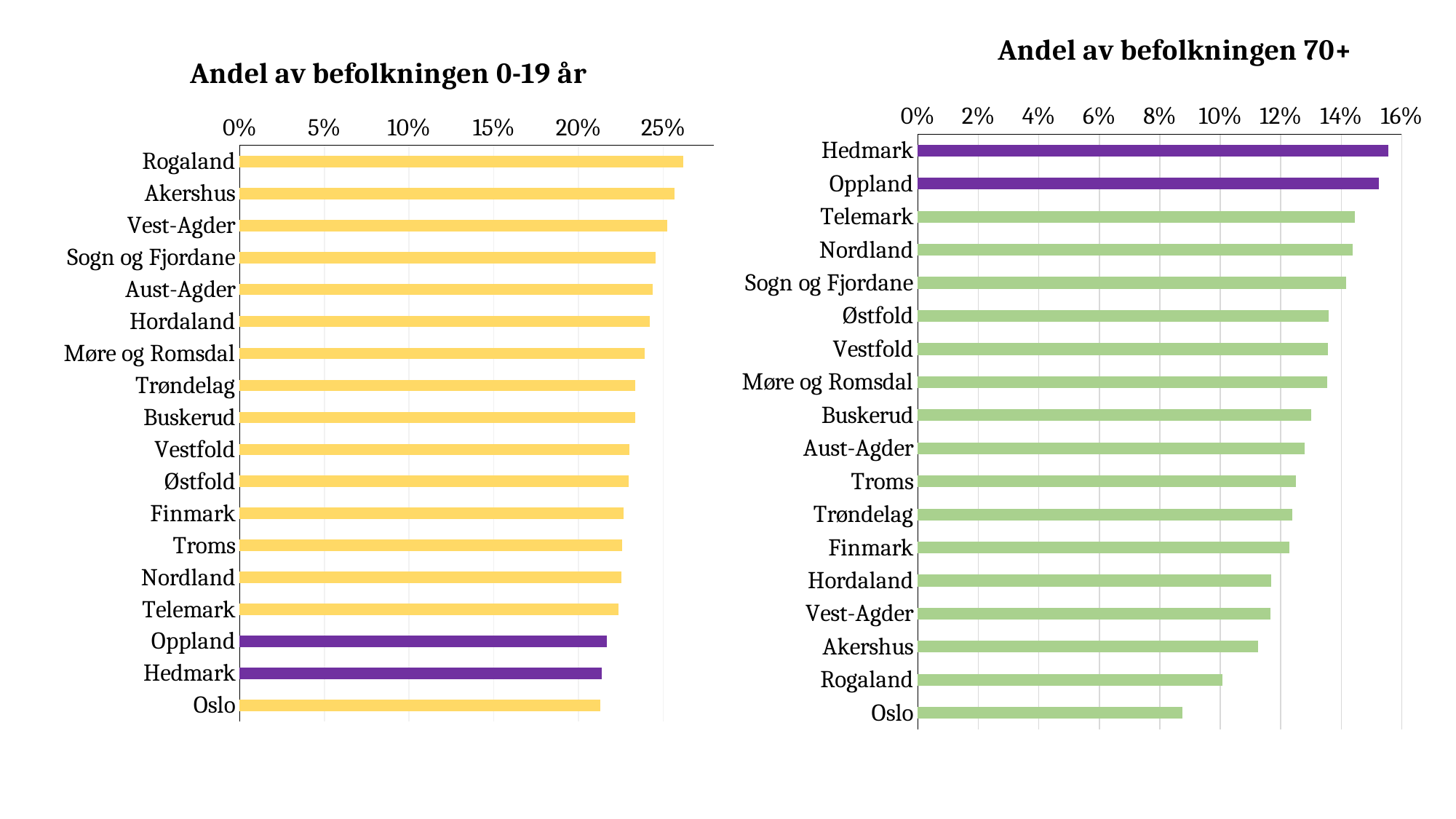
In the 'Andel av befolkningen 0-19 år' chart, which county has the lowest share? Oslo In the 'Andel av befolkningen 70+' chart, which has the larger value, Telemark or Rogaland? Telemark In the 'Andel av befolkningen 70+' chart, is the value for Oslo greater or less than 10%? less In the 'Andel av befolkningen 0-19 år' chart, is the value for Rogaland greater or less than 25%? greater In the 'Andel av befolkningen 70+' chart, which county has the lowest share? Oslo How many counties are shown in the 'Andel av befolkningen 70+' chart? 18 In the 'Andel av befolkningen 70+' chart, is the value for Hedmark greater or less than 14%? greater What kind of chart is the 'Andel av befolkningen 0-19 år' chart? bar chart In the 'Andel av befolkningen 70+' chart, which county has the highest share? Hedmark In the 'Andel av befolkningen 0-19 år' chart, which county has the highest share? Rogaland In the 'Andel av befolkningen 70+' chart, which two counties have purple bars? Hedmark and Oppland